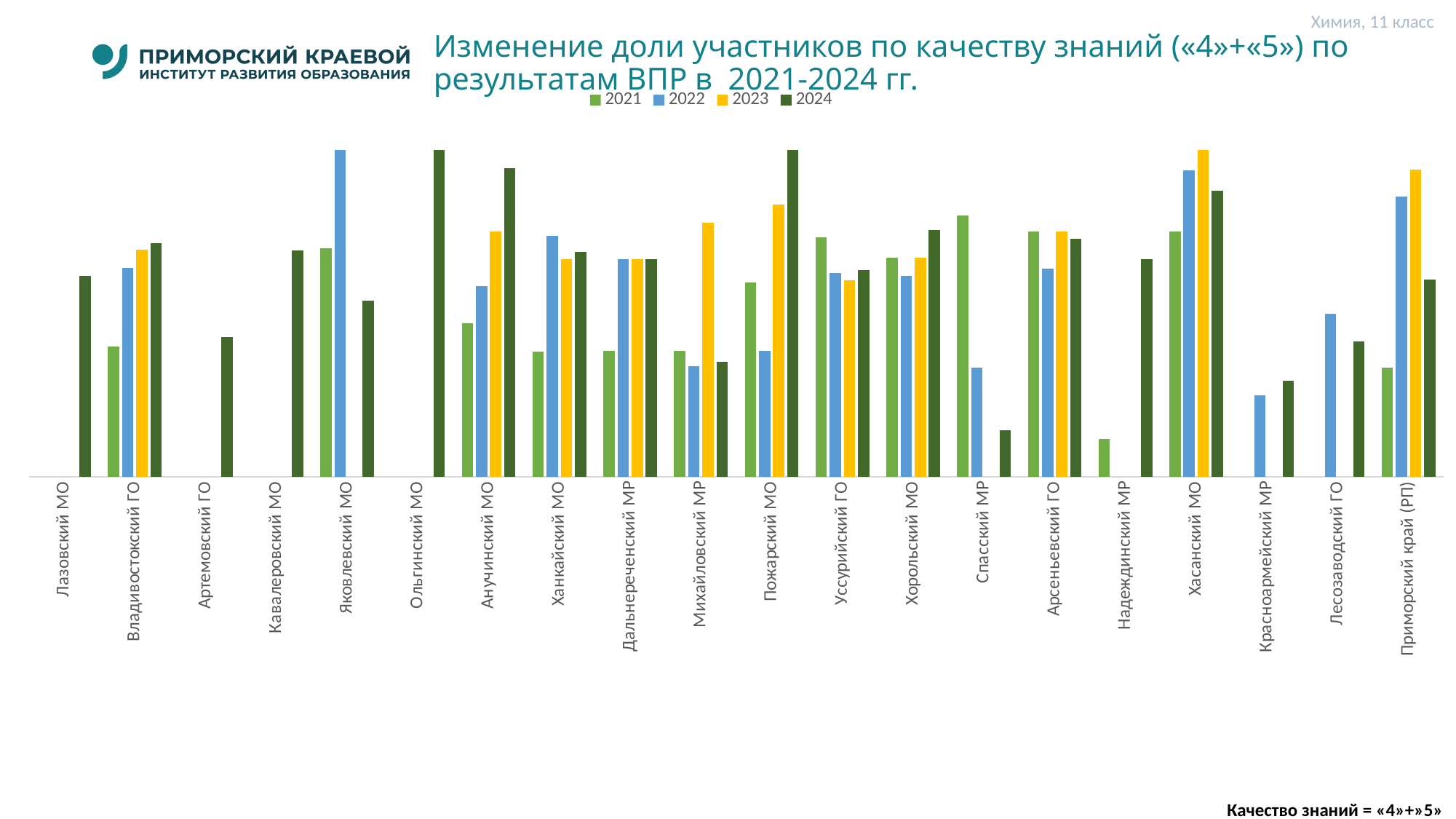
Which years are listed in the legend? 2021, 2022, 2023, 2024 For Приморский край (РП), which year has the lowest value? 2021 How many series does the legend list? 4 How many categories (municipalities) are shown along the x axis? 20 For Спасский МР, which is larger: the 2021 value or the 2024 value? 2021 For Михайловский МР, which is larger: the 2023 value or the 2024 value? 2023 What kind of chart is shown on the slide? bar chart What colour represents the 2023 series in the chart? yellow For Яковлевский МО, which is larger: the 2022 value or the 2024 value? 2022 For Владивостокский ГО, do the values rise or fall from 2021 to 2024? rise For Пожарский МО, which year has the highest value? 2024 For Хасанский МО, which year has the highest value? 2023